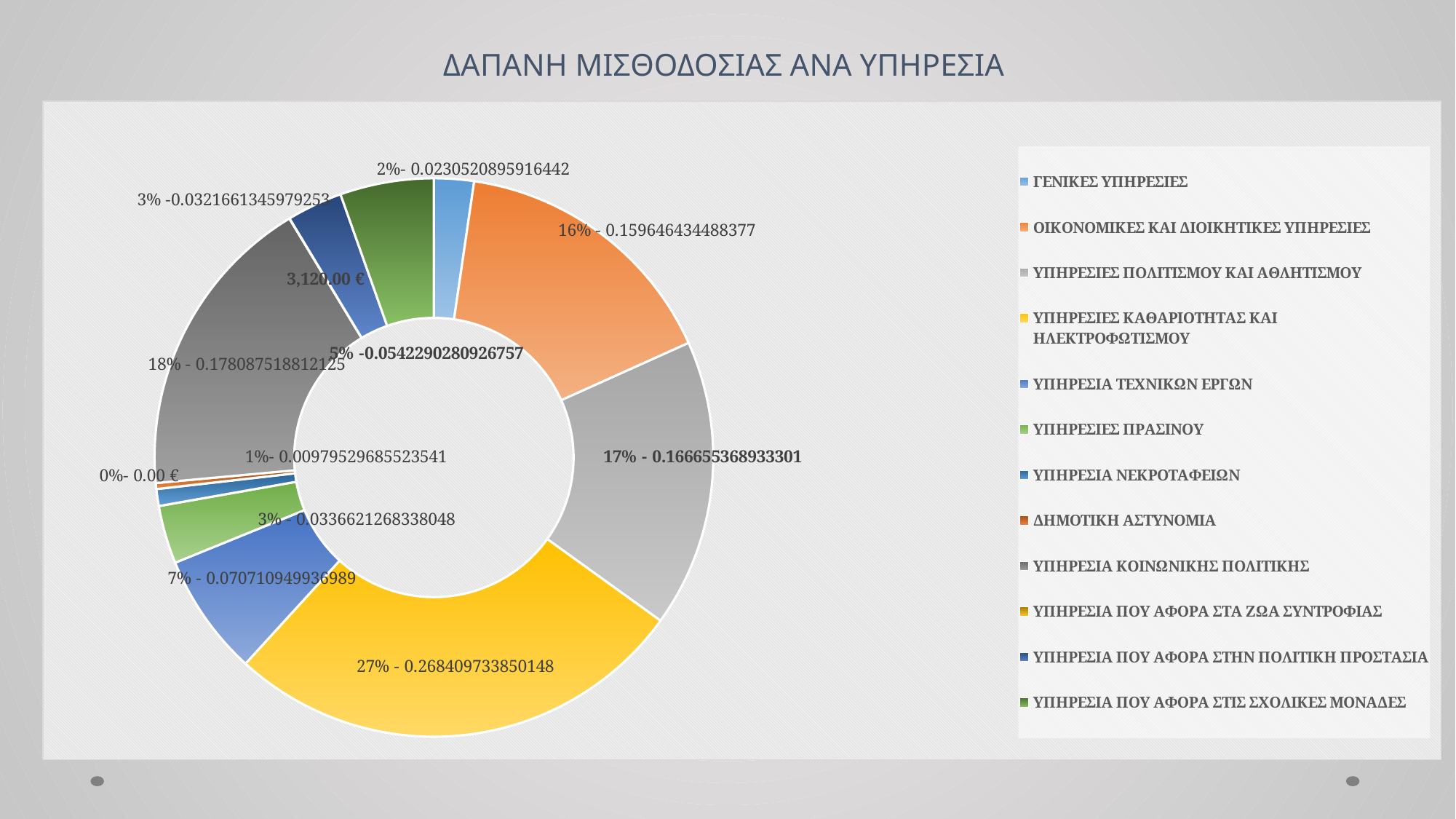
How many categories does the legend list? 12 What percentage share does ΓΕΝΙΚΕΣ ΥΠΗΡΕΣΙΕΣ have? 2% What is the title of the chart? ΔΑΠΑΝΗ ΜΙΣΘΟΔΟΣΙΑΣ ΑΝΑ ΥΠΗΡΕΣΙΑ Which service has the largest share of the chart? ΥΠΗΡΕΣΙΕΣ ΚΑΘΑΡΙΟΤΗΤΑΣ ΚΑΙ ΗΛΕΚΤΡΟΦΩΤΙΣΜΟΥ By how many percentage points does the share of ΥΠΗΡΕΣΙΕΣ ΚΑΘΑΡΙΟΤΗΤΑΣ ΚΑΙ ΗΛΕΚΤΡΟΦΩΤΙΣΜΟΥ exceed that of ΟΙΚΟΝΟΜΙΚΕΣ ΚΑΙ ΔΙΟΙΚΗΤΙΚΕΣ ΥΠΗΡΕΣΙΕΣ? 11 percentage points What percentage share does ΥΠΗΡΕΣΙΑ ΚΟΙΝΩΝΙΚΗΣ ΠΟΛΙΤΙΚΗΣ have? 18% What percentage share does ΥΠΗΡΕΣΙΕΣ ΠΟΛΙΤΙΣΜΟΥ ΚΑΙ ΑΘΛΗΤΙΣΜΟΥ have? 17% What kind of chart is shown on the slide? Doughnut (pie) chart Which has the larger share: ΥΠΗΡΕΣΙΑ ΚΟΙΝΩΝΙΚΗΣ ΠΟΛΙΤΙΚΗΣ or ΥΠΗΡΕΣΙΕΣ ΠΟΛΙΤΙΣΜΟΥ ΚΑΙ ΑΘΛΗΤΙΣΜΟΥ? ΥΠΗΡΕΣΙΑ ΚΟΙΝΩΝΙΚΗΣ ΠΟΛΙΤΙΚΗΣ